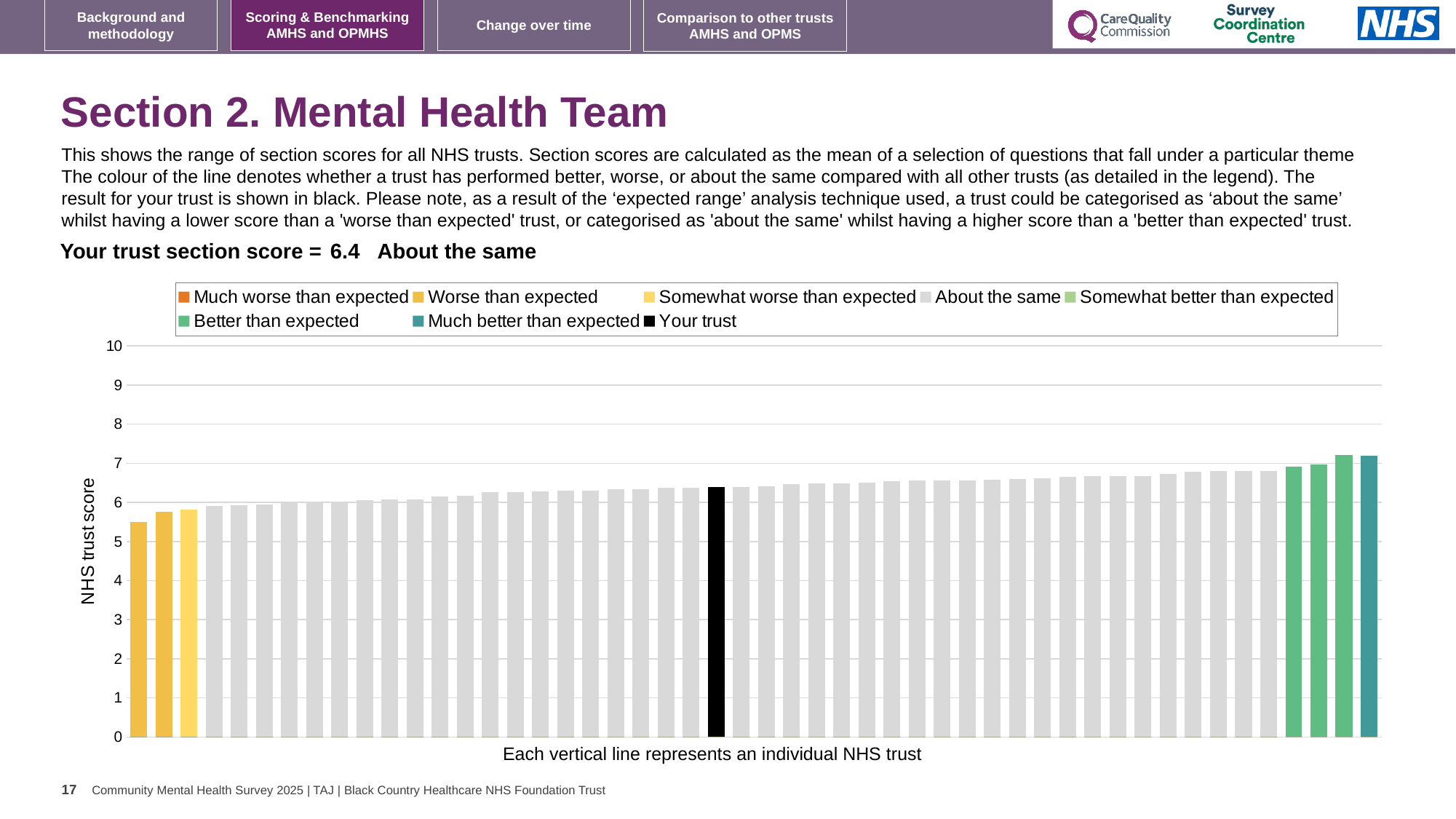
What kind of chart is shown on the slide? bar chart What is the trust's section score for Mental Health Team shown on the slide? 6.4 Which is higher, the rightmost bar or the black bar for Your trust? the rightmost bar How many entries does the chart legend list? 8 Which is higher, the leftmost bar or the black bar for Your trust? the black bar (Your trust) Which category is the trust's section score placed in, according to the text above the chart? About the same Is the value of the leftmost bar greater or less than 6? less Is the value of the tallest bar greater or less than 8? less Do the bar values rise or fall from left to right across the chart? rise Is the value of the black bar (Your trust) greater or less than 6? greater What is the label on the vertical axis of the chart? NHS trust score